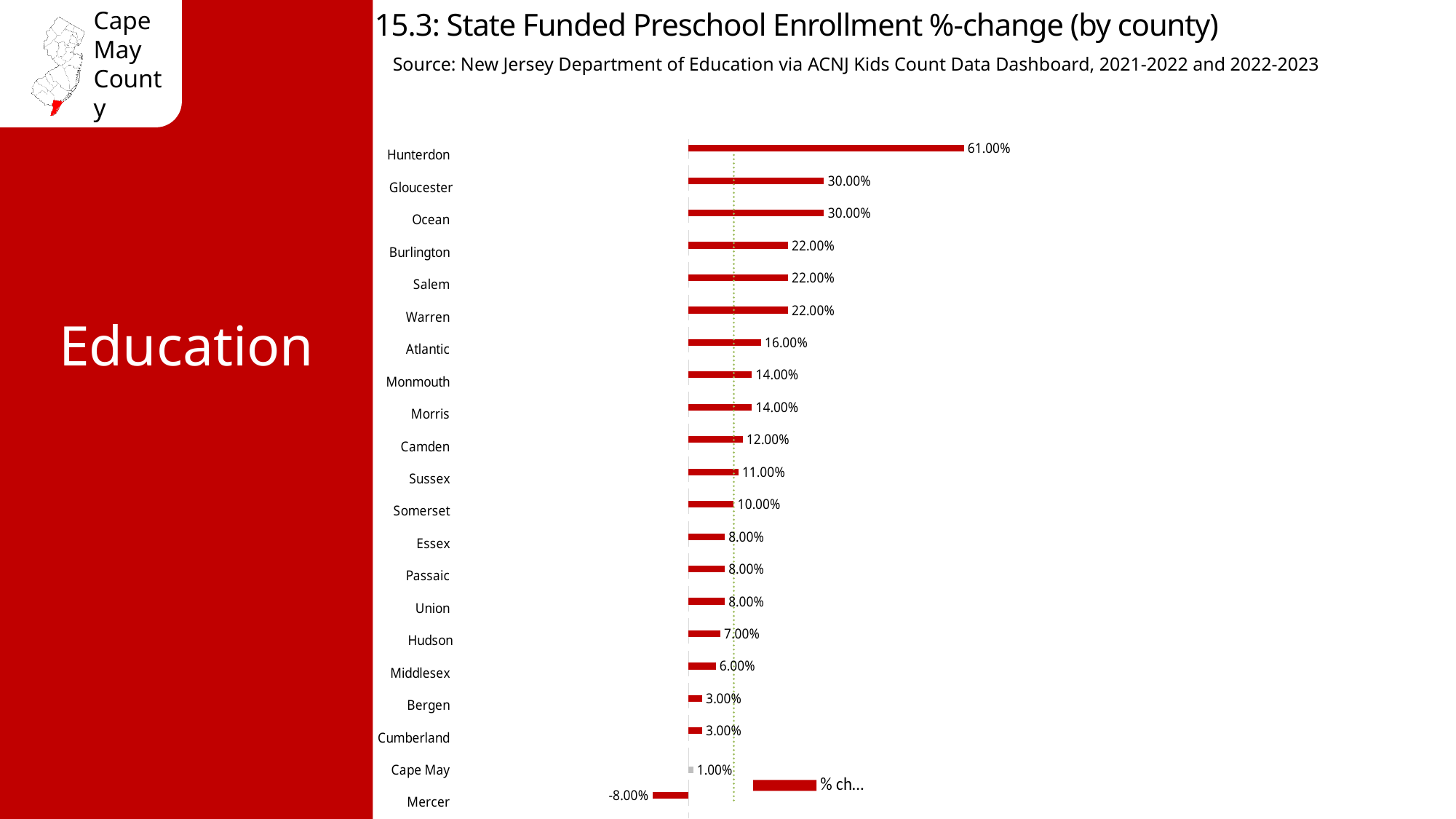
Which county has the highest %-change? Hunterdon What is the difference between the values for Hunterdon and Gloucester? 31.00% What is the state funded preschool enrollment %-change for Hunterdon? 61.00% Which has a larger value, Burlington or Camden? Burlington Which county has the lowest %-change? Mercer How many counties are shown in the chart? 21 What kind of chart is shown on the slide? Bar chart What is the title of the chart? 15.3: State Funded Preschool Enrollment %-change (by county) What is the value shown for Mercer? -8.00% What is the value shown for Atlantic? 16.00% What is the value shown for Cape May? 1.00% What is the difference between the values for Cumberland and Cape May? 2.00%